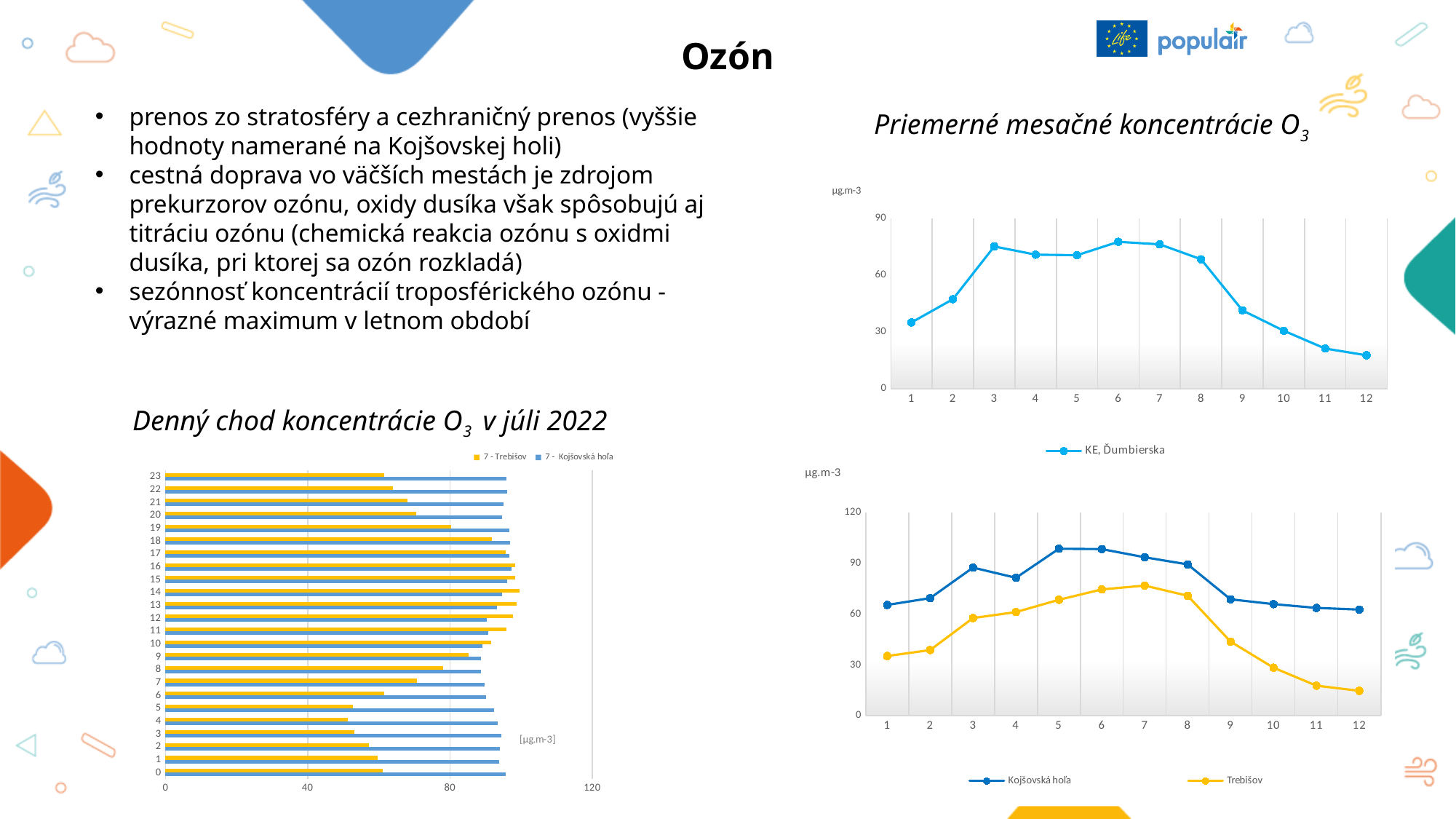
In the 'Denný chod koncentrácie O3 v júli 2022' chart, is the value for 7 - Trebišov at hour 0 greater or less than 80? less How many series does the legend of the 'Denný chod koncentrácie O3 v júli 2022' chart list? 2 How many hour categories are shown on the 'Denný chod koncentrácie O3 v júli 2022' chart? 24 In the top-right chart (KE, Ďumbierska), do the values rise or fall from month 8 to month 12? fall In the bottom-right chart, which series has the larger value at month 1, Kojšovská hoľa or Trebišov? Kojšovská hoľa In the top-right chart (KE, Ďumbierska), which month has the lowest value? 12 What kind of chart is the top-right chart with the series KE, Ďumbierska? line chart In the bottom-right chart, which month has the lowest value for Trebišov? 12 In the 'Denný chod koncentrácie O3 v júli 2022' chart, which series has the larger value at hour 0, 7 - Trebišov or 7 - Kojšovská hoľa? 7 - Kojšovská hoľa What kind of chart is the 'Denný chod koncentrácie O3 v júli 2022' chart? bar chart In the top-right chart (KE, Ďumbierska), is the value for month 1 greater or less than 60? less In the bottom-right chart, is the value for Kojšovská hoľa at month 5 greater or less than 90? greater